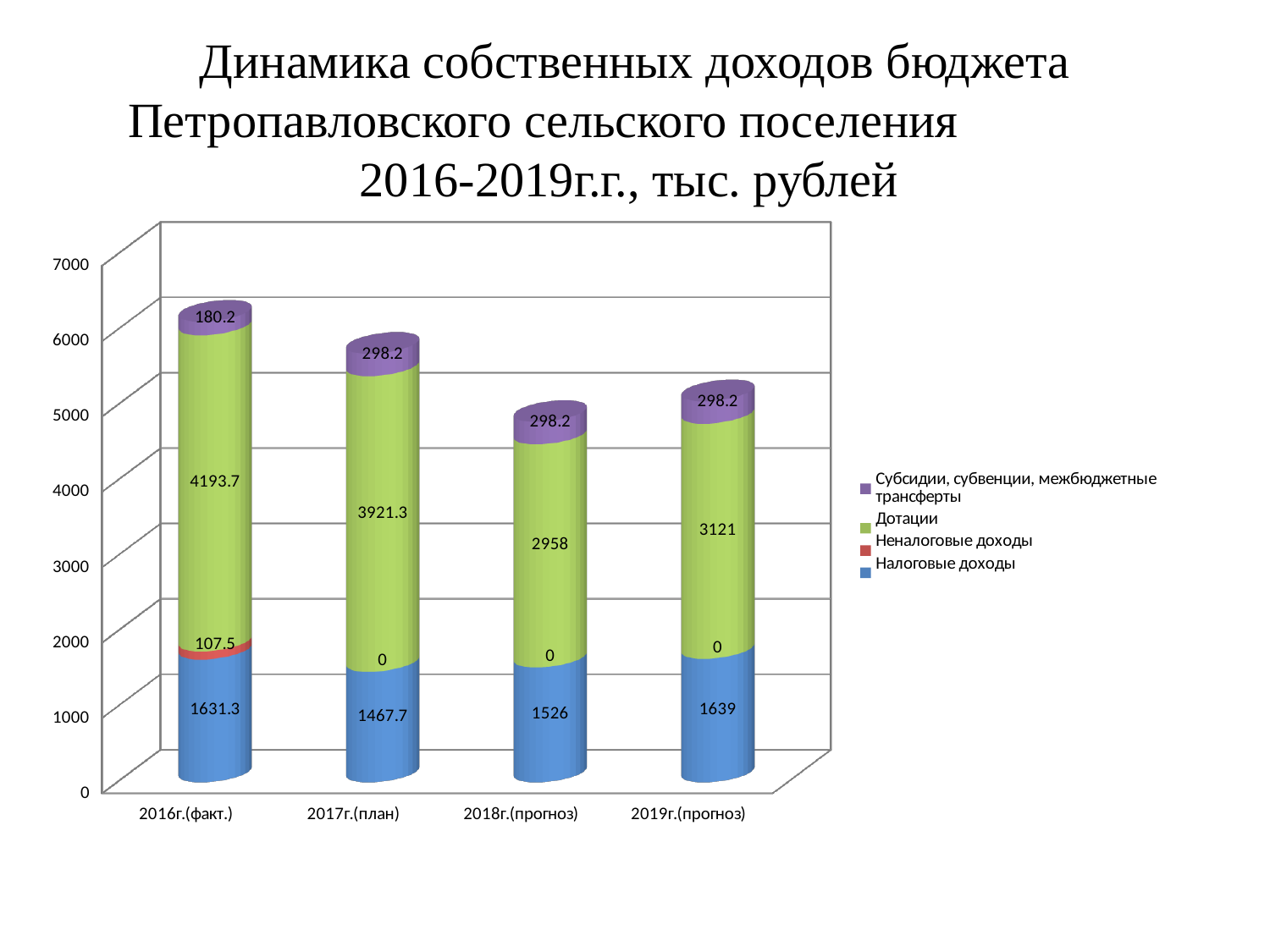
How many series does the legend list? 4 What is the value of Субсидии, субвенции, межбюджетные трансферты for 2017г.(план)? 298.2 What is the value of Дотации for 2018г.(прогноз)? 2958 What is the difference between the Дотации values for 2017г.(план) and 2018г.(прогноз)? 963.3 Which category has the lowest value for Налоговые доходы? 2017г.(план) What is the value of Налоговые доходы for 2016г.(факт.)? 1631.3 What is the value of Неналоговые доходы for 2019г.(прогноз)? 0 Which is larger: Налоговые доходы for 2018г.(прогноз) or for 2019г.(прогноз)? 2019г.(прогноз) What kind of chart is shown on the slide? Stacked bar chart What is the total of the stacked bar for 2016г.(факт.)? 6112.7 How many categories are shown on the x axis? 4 Which category has the highest value for Дотации? 2016г.(факт.)